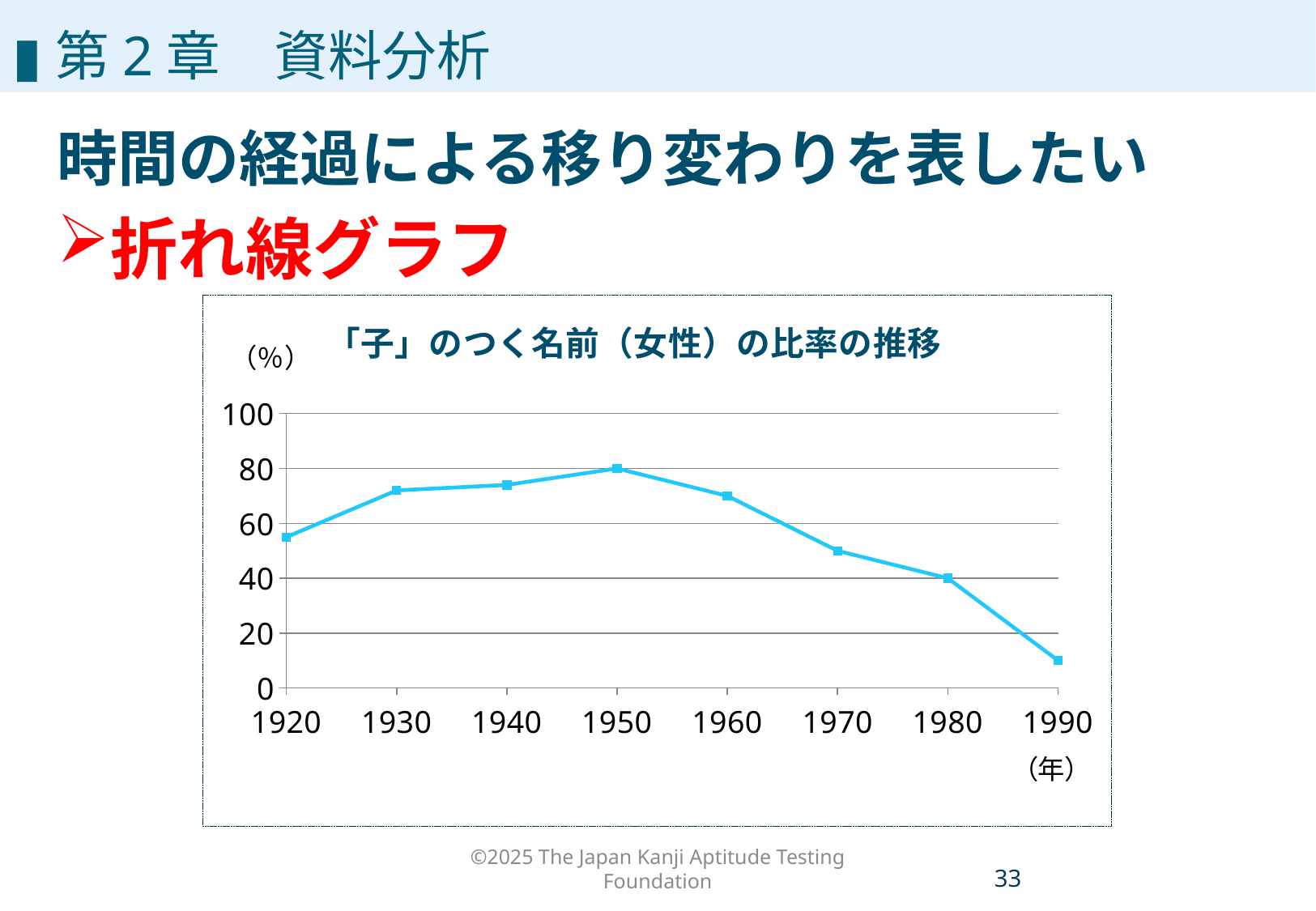
What kind of chart is shown on the slide? line chart Is the value for 1990 greater or less than 20? less What is the value for 1950? 80 What is the value for 1980? 40 What is the difference between the values for 1950 and 1980? 40 Is the value for 1920 greater or less than 40? greater How many years (data points) are plotted on the x axis? 8 What is the title of the chart? 「子」のつく名前（女性）の比率の推移 Does the line rise or fall between 1950 and 1990? fall Which year has the larger value, 1960 or 1970? 1960 In which year is the ratio lowest? 1990 In which year is the ratio highest? 1950